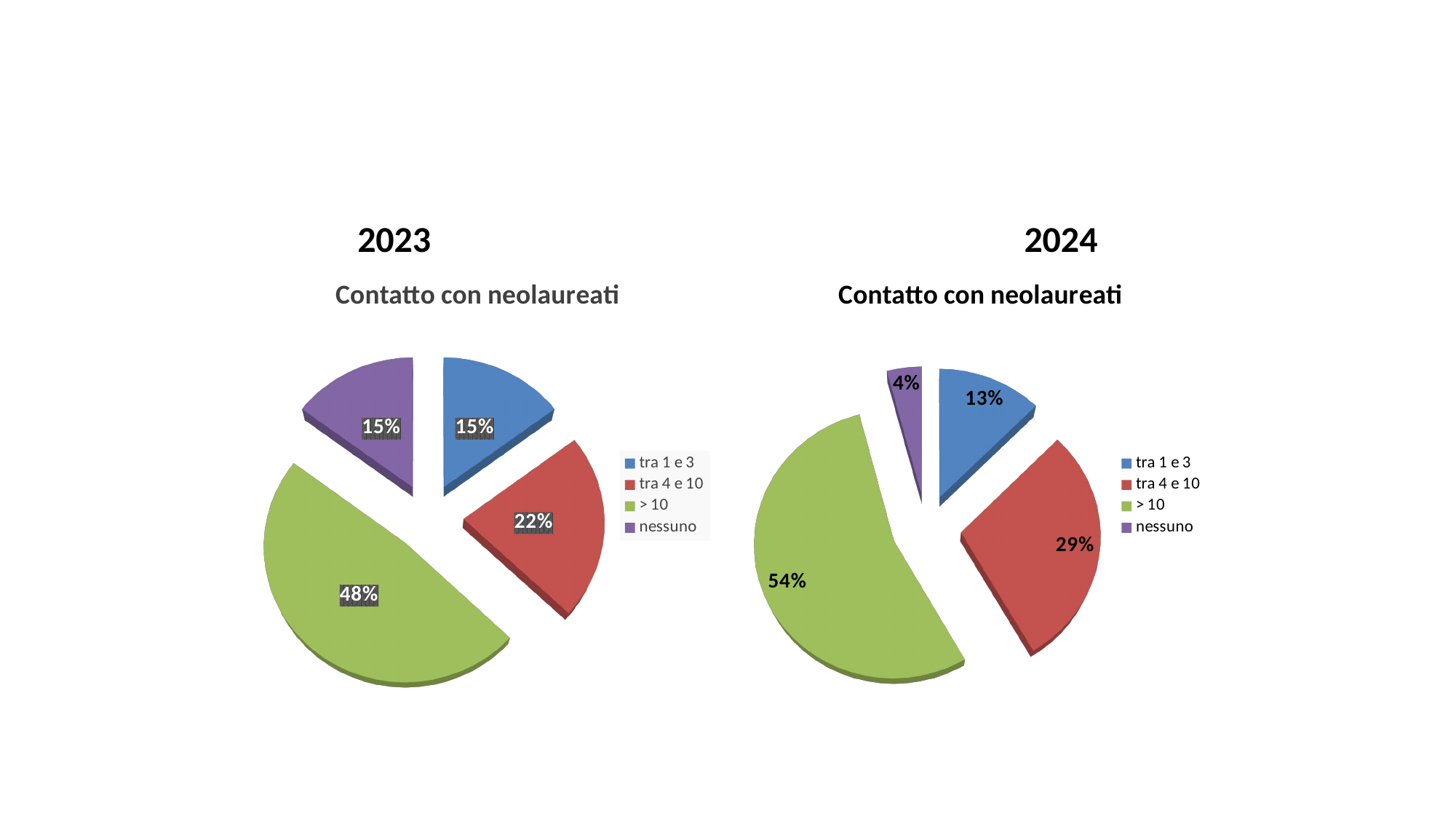
In the 2023 chart, which category has the largest slice? > 10 What is the title of the 2023 chart? Contatto con neolaureati In the 2023 chart, which is larger: 'tra 4 e 10' or 'nessuno'? tra 4 e 10 In the 2023 chart, what share does the '> 10' slice have? 48% In the 2024 chart, what share does the 'nessuno' slice have? 4% In the 2024 chart, which category has the smallest slice? nessuno In the 2024 chart, what is the difference between the '> 10' slice and the 'tra 4 e 10' slice? 25% In the 2023 chart, which colour represents the 'nessuno' category? Purple In the 2024 chart, what share does the 'tra 4 e 10' slice have? 29% How many slices does the 2023 chart have? 4 What kind of chart is the 2024 chart? Pie chart How many entries does the legend of the 2024 chart list? 4